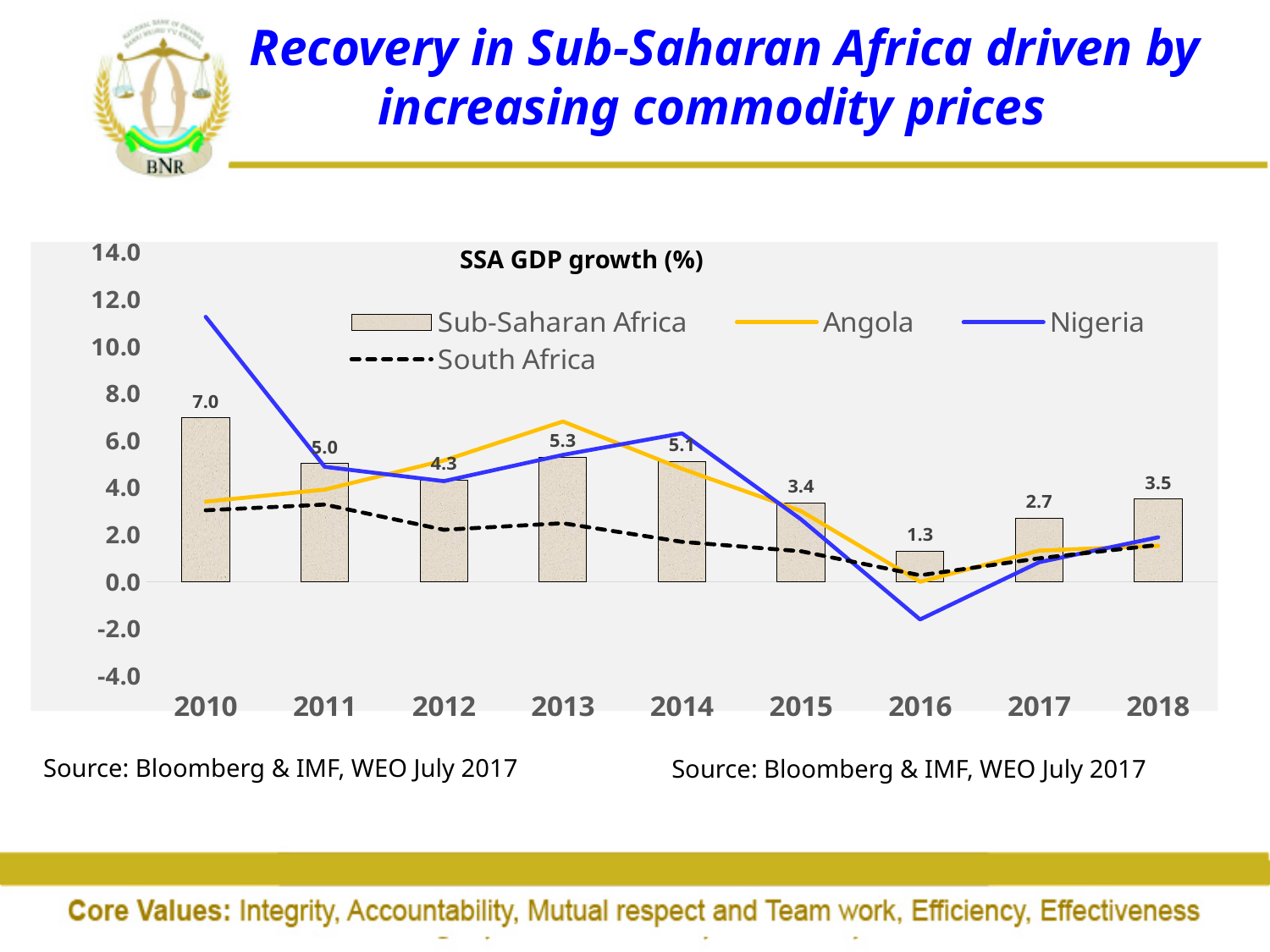
Is the Nigeria value for 2016 greater or less than 0.0? less What is the difference between the Sub-Saharan Africa values for 2010 and 2016? 5.7 What is the Sub-Saharan Africa GDP growth value for 2018? 3.5 What is the Sub-Saharan Africa GDP growth value for 2016? 1.3 How many years are shown on the x axis? 9 What is the Sub-Saharan Africa GDP growth value for 2010? 7.0 Which year has the larger Sub-Saharan Africa value, 2011 or 2012? 2011 Which series is drawn as a dashed line? South Africa Is the Nigeria value for 2010 greater or less than 10.0? greater In which year is the Sub-Saharan Africa bar the lowest? 2016 How many series does the legend list? 4 In which year is the Sub-Saharan Africa bar the highest? 2010